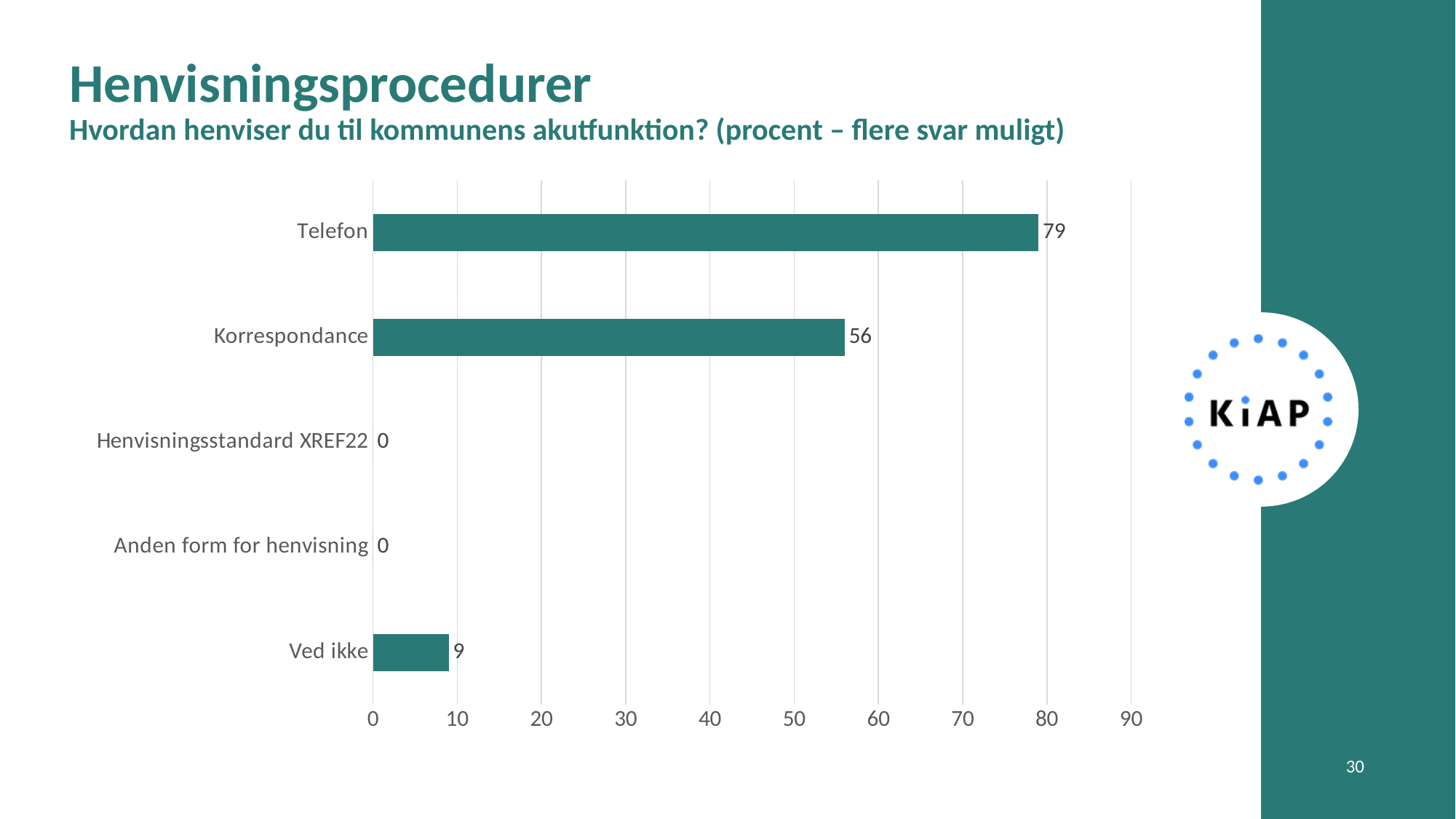
What is the value for Telefon? 79 Which is larger, the value for Korrespondance or the value for Ved ikke? Korrespondance How many categories have a value of 0? 2 Is the value for Korrespondance greater or less than 50? greater What kind of chart is shown on the slide? bar chart What is the value for Ved ikke? 9 What is the value for Henvisningsstandard XREF22? 0 Which category has the highest value? Telefon What is the title of the slide? Henvisningsprocedurer How many categories are shown in the chart? 5 What is the value for Korrespondance? 56 What is the difference between the values for Telefon and Korrespondance? 23